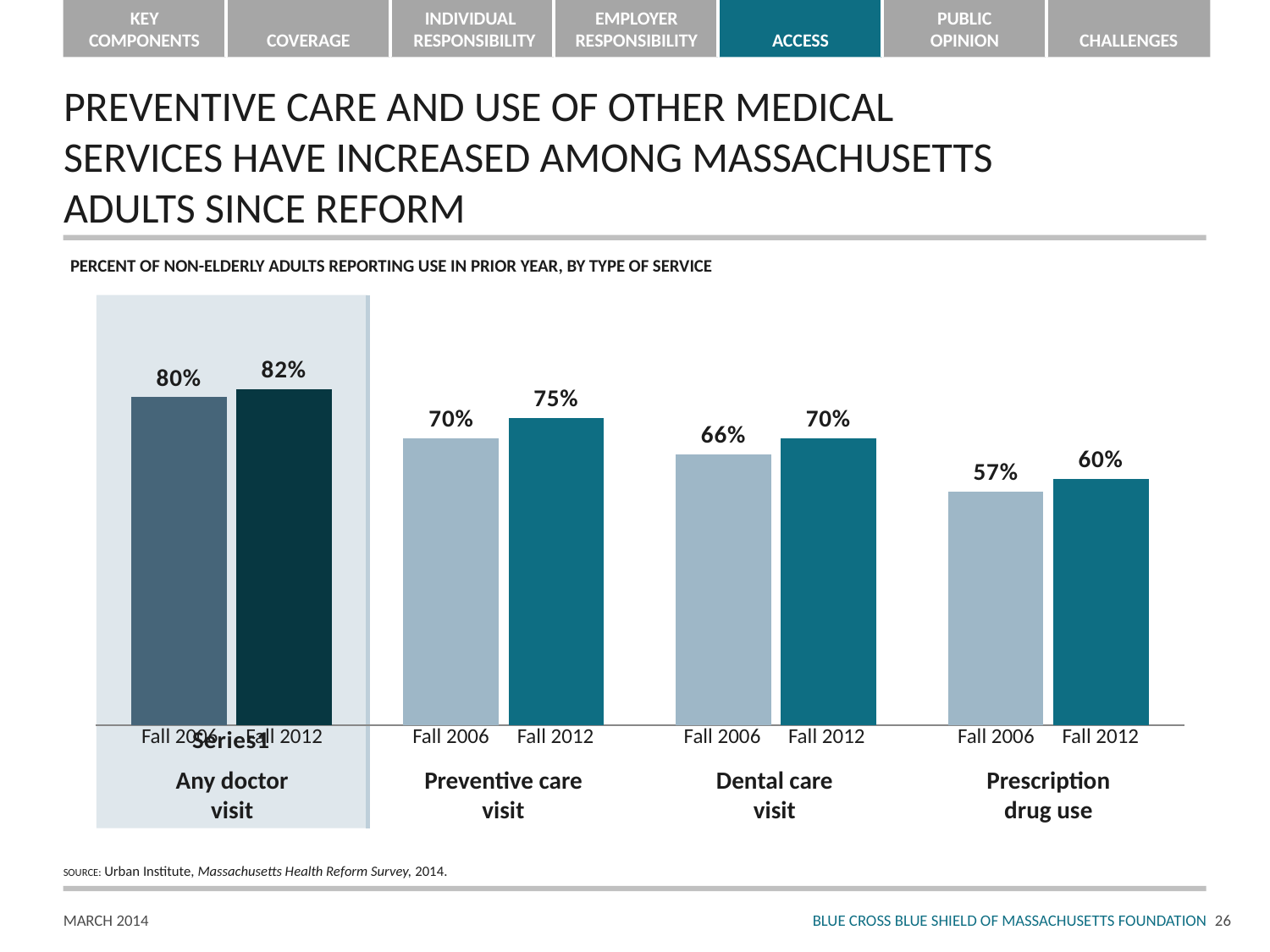
What percent of non-elderly adults reported a preventive care visit in Fall 2012? 75% By how many percentage points did preventive care visits increase from Fall 2006 to Fall 2012? 5 percentage points Which is larger: dental care visit in Fall 2012 or preventive care visit in Fall 2006? They are equal (70%) Which type of service had the lowest reported use in Fall 2006? Prescription drug use How many types of service are shown in the chart? 4 For each type of service, did reported use rise or fall from Fall 2006 to Fall 2012? Rise What was the value for dental care visit in Fall 2006? 66% Which type of service had the highest reported use in Fall 2012? Any doctor visit What percent reported prescription drug use in Fall 2012? 60% What is the difference between the Fall 2012 values for any doctor visit and prescription drug use? 22 percentage points What kind of chart is shown on the slide? Bar chart What was the value for any doctor visit in Fall 2006? 80%